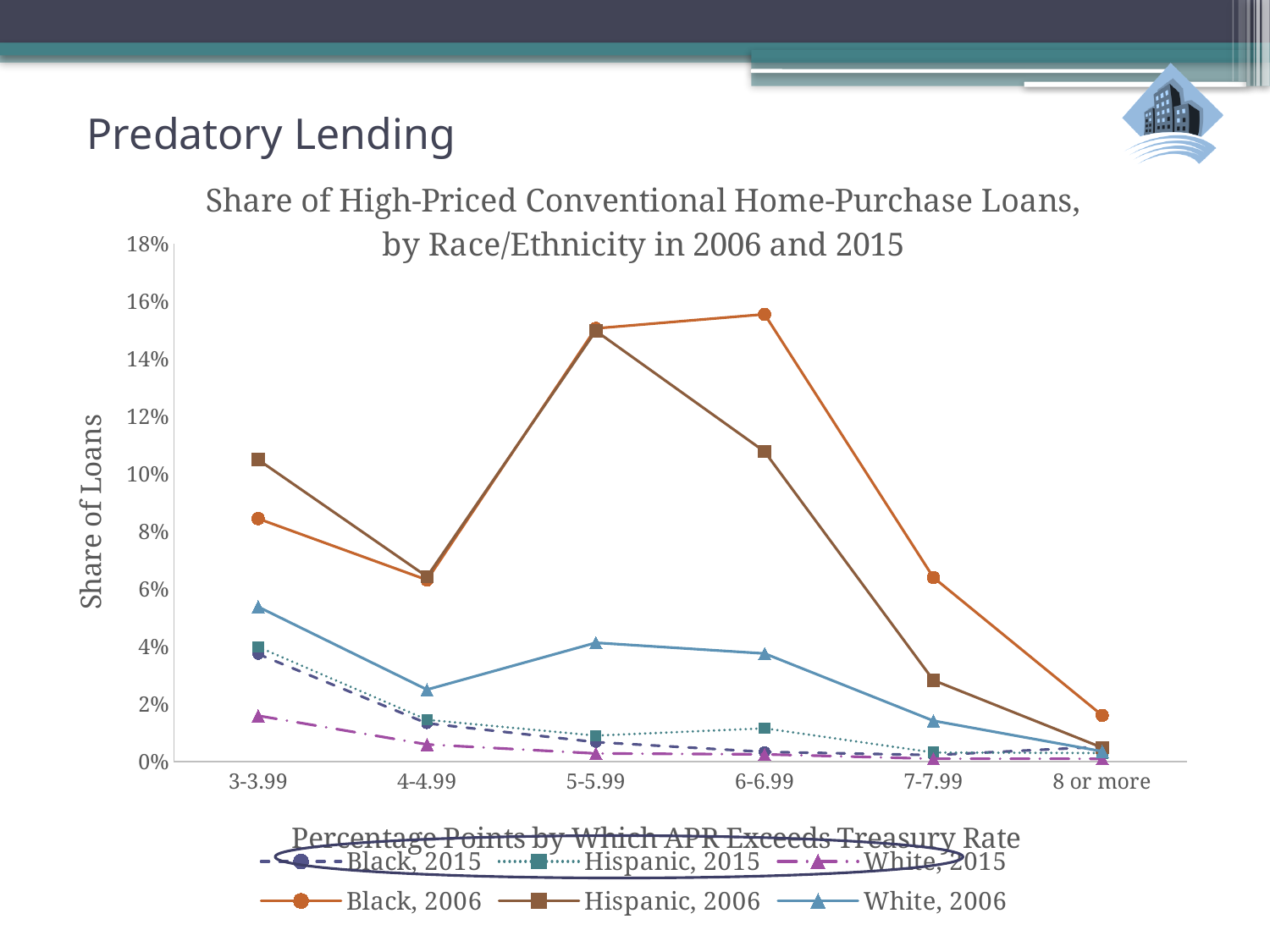
Which series has the highest value at the 3-3.99 category? Hispanic, 2006 Which series has the highest value at the 6-6.99 category? Black, 2006 What is the title of the vertical axis? Share of Loans How many series does the legend list? 6 Is the value for White, 2015 at 3-3.99 greater or less than 2%? less Is the value for Black, 2006 at 6-6.99 greater or less than 14%? greater What kind of chart is shown on the slide? Line chart In which category does the Hispanic, 2006 series reach its highest value? 5-5.99 Does the Black, 2006 line rise or fall from 6-6.99 to 8 or more? Falls At the 3-3.99 category, which is larger: Hispanic, 2006 or Black, 2006? Hispanic, 2006 How many categories are shown on the x axis? 6 Is the value for Hispanic, 2006 at 7-7.99 greater or less than 4%? less